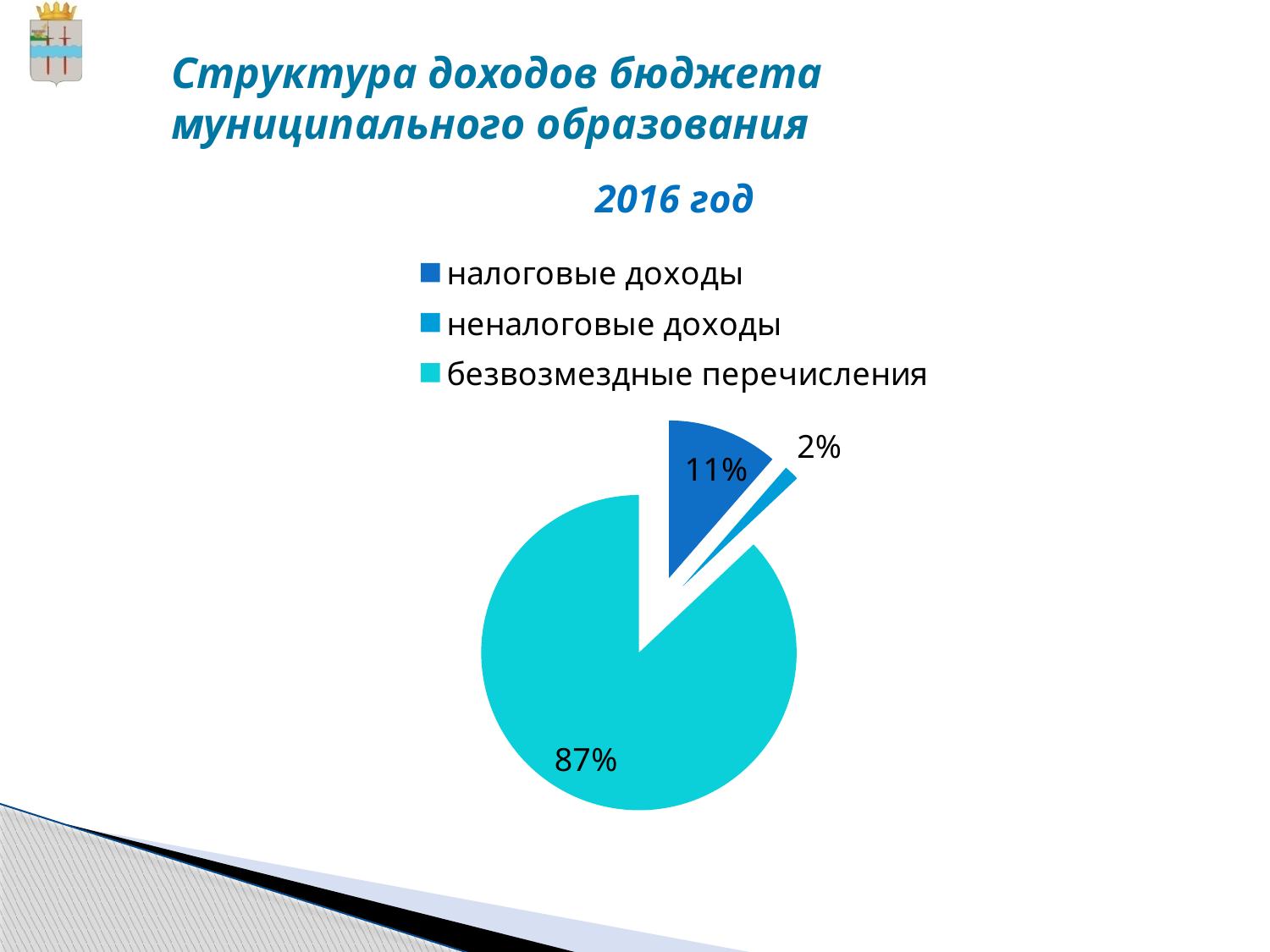
Which is larger, налоговые доходы or неналоговые доходы? налоговые доходы Which category has the largest slice of the pie? безвозмездные перечисления What share of the pie does неналоговые доходы have? 2% What is the difference in percentage points between налоговые доходы and неналоговые доходы? 9 What kind of chart is shown on the slide? pie chart What share of the pie does налоговые доходы have? 11% How many slices does the pie chart have? 3 What year is shown in the chart title? 2016 год Which category has the smallest slice of the pie? неналоговые доходы What share of the pie does безвозмездные перечисления have? 87% How many entries does the legend list? 3 What is the difference in percentage points between безвозмездные перечисления and налоговые доходы? 76